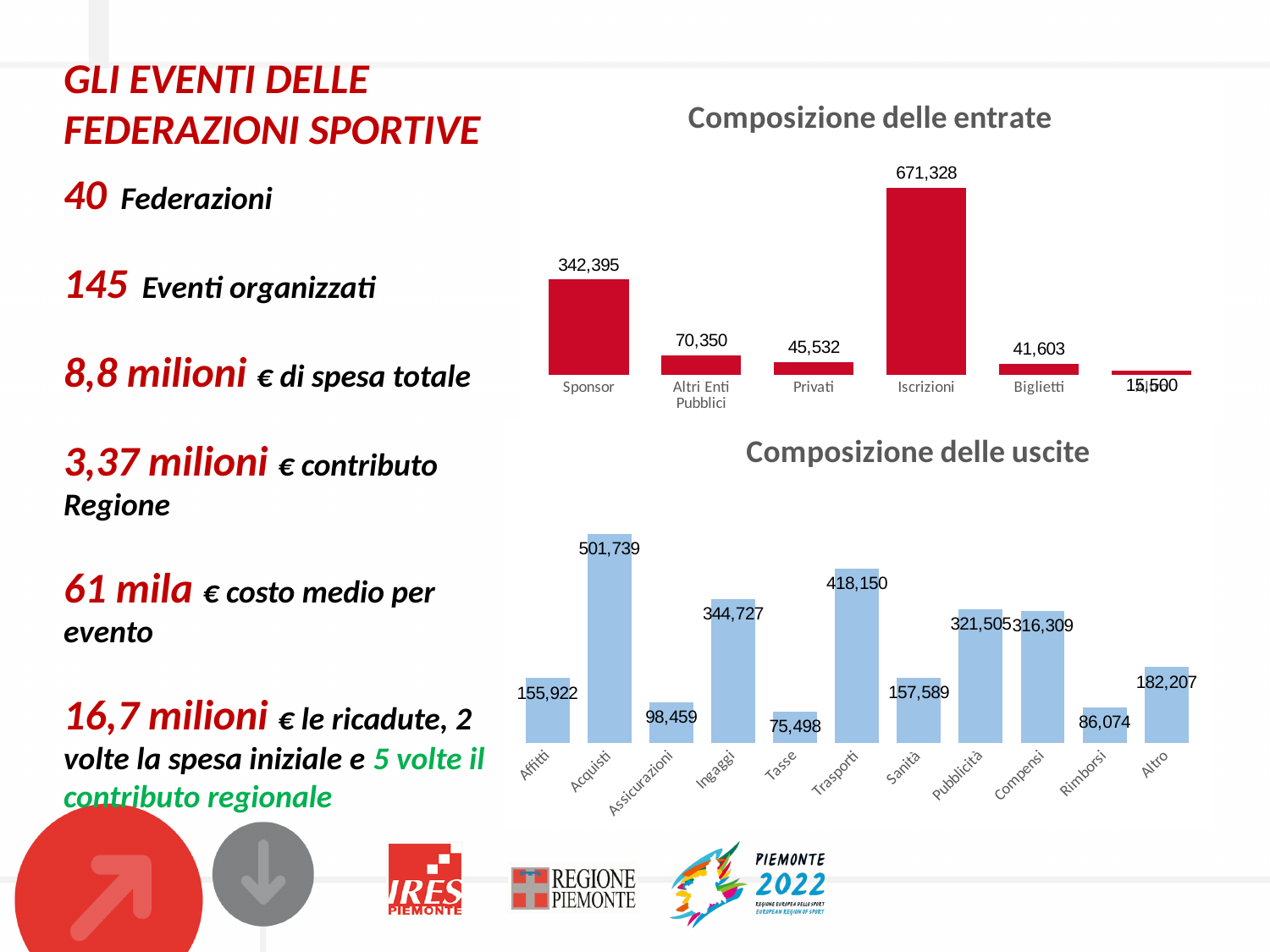
In the 'Composizione delle entrate' chart, which category has the highest value? Iscrizioni In the 'Composizione delle entrate' chart, which is larger, Privati or Biglietti? Privati In the 'Composizione delle uscite' chart, which is larger, Pubblicità or Compensi? Pubblicità In the 'Composizione delle uscite' chart, what is the difference between Acquisti and Ingaggi? 157,012 In the 'Composizione delle uscite' chart, which category has the lowest value? Tasse In the 'Composizione delle uscite' chart, which category has the highest value? Acquisti In the 'Composizione delle uscite' chart, what is the value for Trasporti? 418,150 In the 'Composizione delle uscite' chart, how many categories are shown? 11 In the 'Composizione delle entrate' chart, what is the value for Iscrizioni? 671,328 In the 'Composizione delle entrate' chart, what is the value for Sponsor? 342,395 In the 'Composizione delle entrate' chart, what is the difference between Sponsor and Altri Enti Pubblici? 272,045 What type of chart is 'Composizione delle uscite'? Bar chart